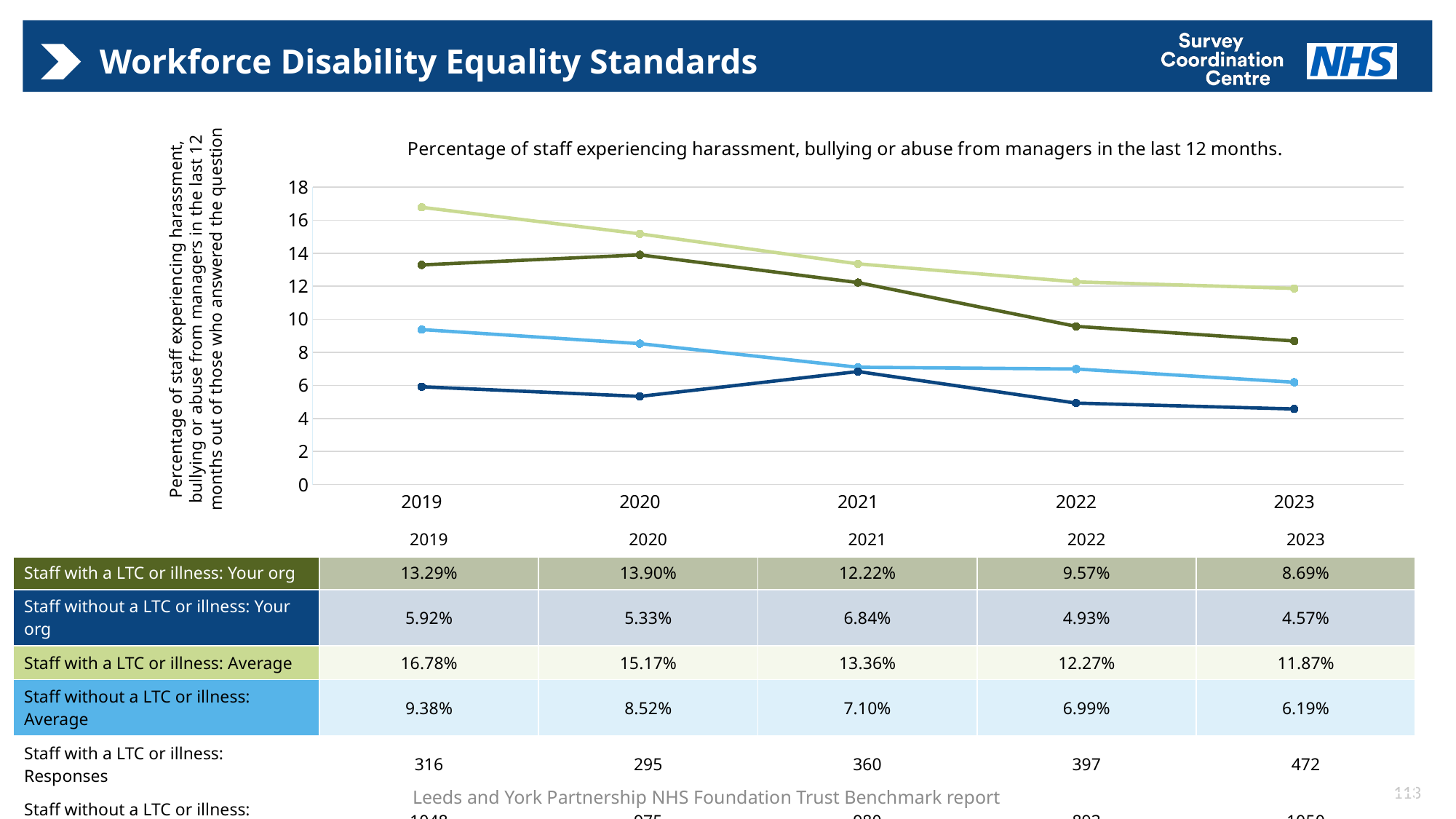
What is the difference between 'Staff with a LTC or illness: Average' and 'Staff with a LTC or illness: Your org' in 2023? 3.18% Which is larger in 2020: 'Staff with a LTC or illness: Your org' or 'Staff without a LTC or illness: Average'? Staff with a LTC or illness: Your org What is the value for 'Staff with a LTC or illness: Average' in 2019? 16.78% In which year is the value for 'Staff with a LTC or illness: Your org' lowest? 2023 In which year is the value for 'Staff without a LTC or illness: Your org' highest? 2021 How many years are plotted along the x axis of the chart? 5 What is the value for 'Staff without a LTC or illness: Average' in 2023? 6.19% What type of chart is shown on the slide? line chart What is the title of the chart? Percentage of staff experiencing harassment, bullying or abuse from managers in the last 12 months. What is the value for 'Staff with a LTC or illness: Your org' in 2021? 12.22% How many data series are plotted in the chart? 4 Does the value for 'Staff with a LTC or illness: Average' rise or fall from 2019 to 2023? fall